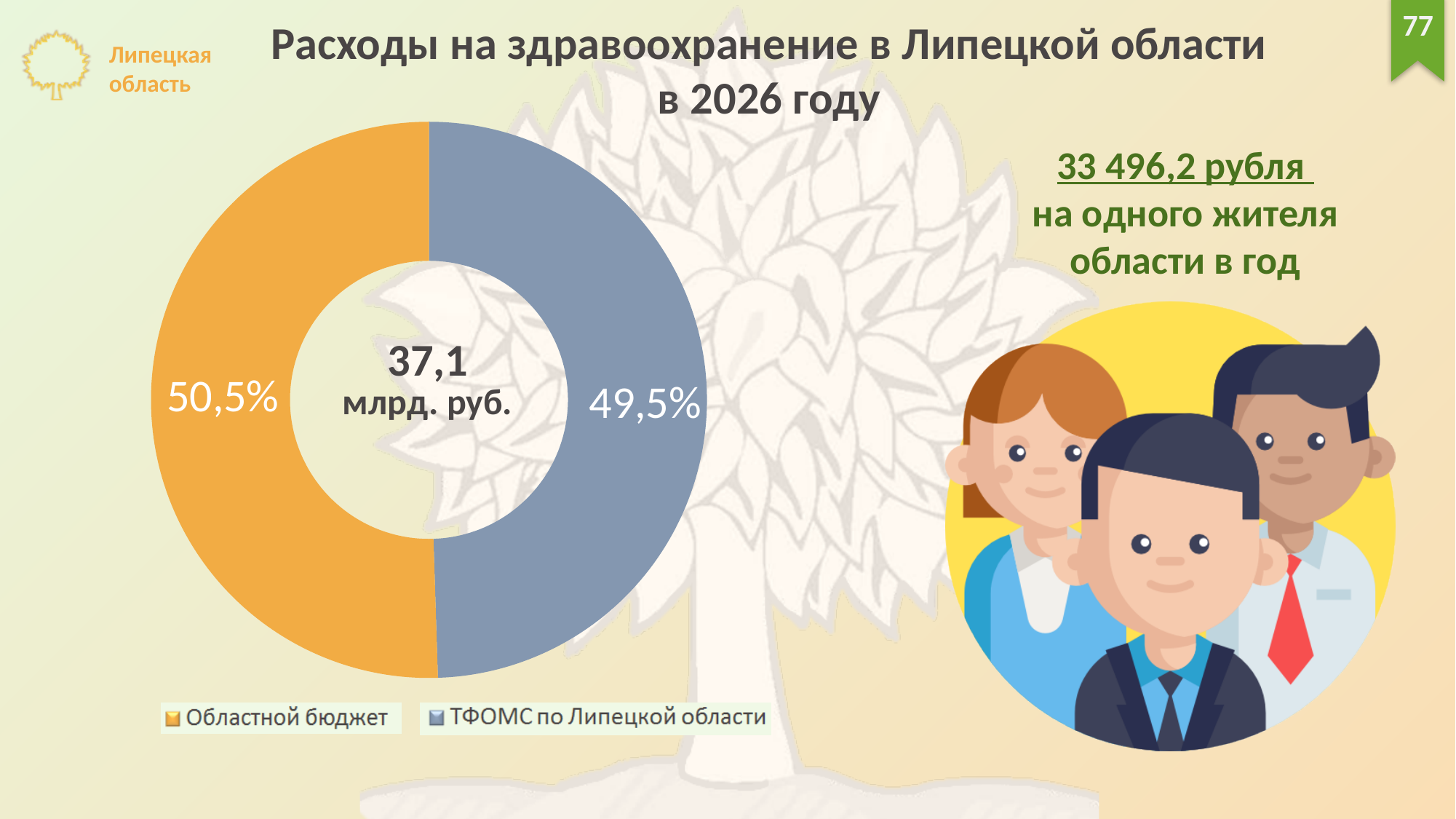
What share of the chart does ТФОМС по Липецкой области account for? 49,5% How many categories does the chart show? 2 Which category has the smallest share in the chart? ТФОМС по Липецкой области What kind of chart is shown on the slide? Doughnut (pie) chart What total value is printed in the centre of the chart? 37,1 млрд. руб. Which category has the larger share, Областной бюджет or ТФОМС по Липецкой области? Областной бюджет What is the difference in percentage points between the shares of Областной бюджет and ТФОМС по Липецкой области? 1 percentage point Which colour represents ТФОМС по Липецкой области in the chart? Blue-grey What is the title of the chart on the slide? Расходы на здравоохранение в Липецкой области в 2026 году Which category has the largest share in the chart? Областной бюджет What share of the chart does Областной бюджет account for? 50,5%